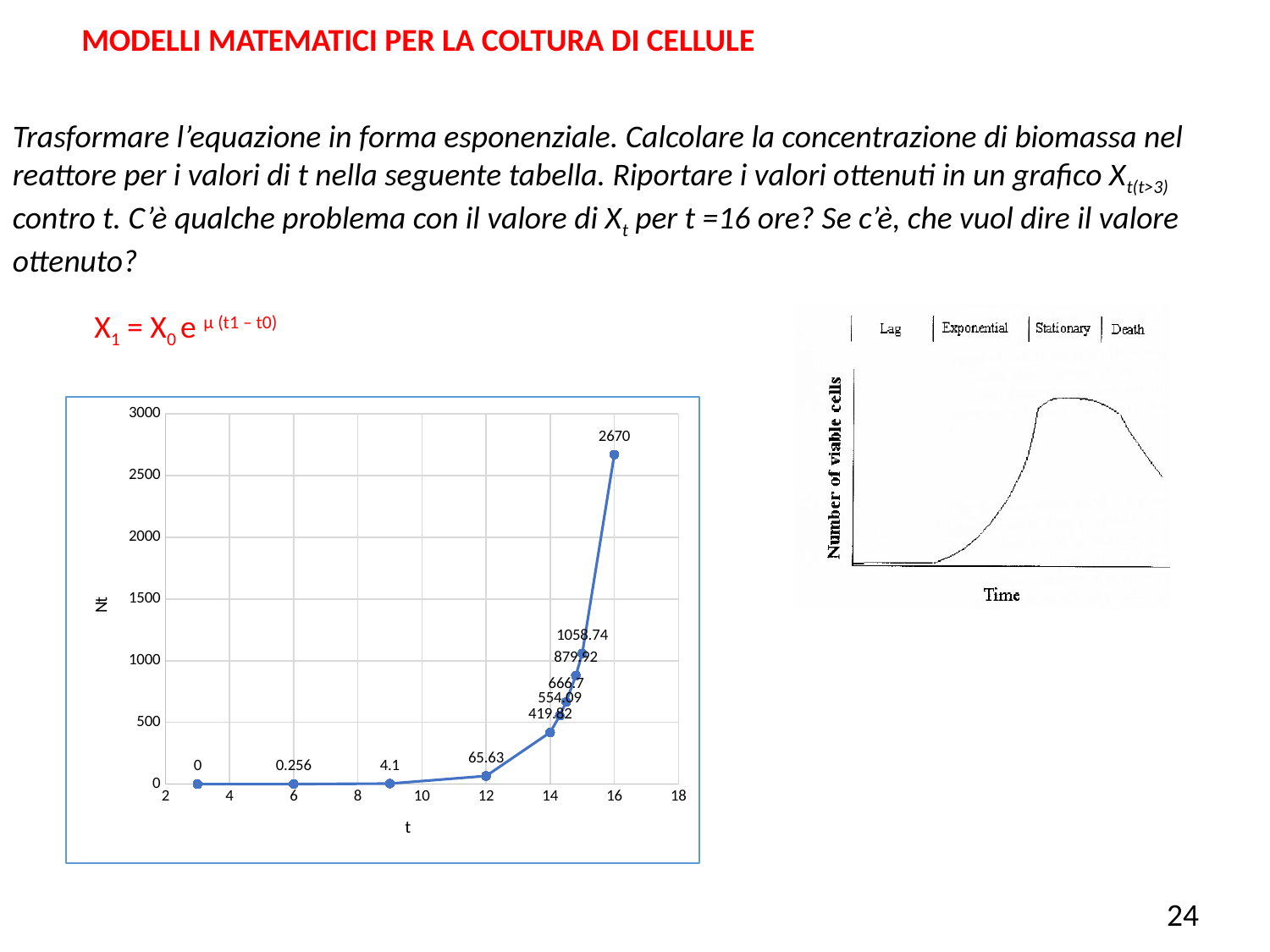
In the left chart, what is the value of Nt at t = 9? 4.1 In the left chart, do the values of Nt rise or fall as t increases? rise In the left chart, what is the value of Nt at t = 6? 0.256 In the left chart, what is the difference between the highest value (2670) and the second highest value (1058.74)? 1611.26 In the left chart, what is the highest plotted value of Nt? 2670 What kind of chart is the left chart? line chart In the left chart, which is larger: the value at t = 12 or the value at t = 16? t = 16 How many data points are plotted in the left chart? 10 In the left chart, is the value of Nt at t = 16 greater or less than 2500? greater In the left chart, what is the lowest plotted value of Nt? 0 In the left chart, what is the value of Nt at t = 16? 2670 In the left chart, what is the value of Nt at t = 12? 65.63